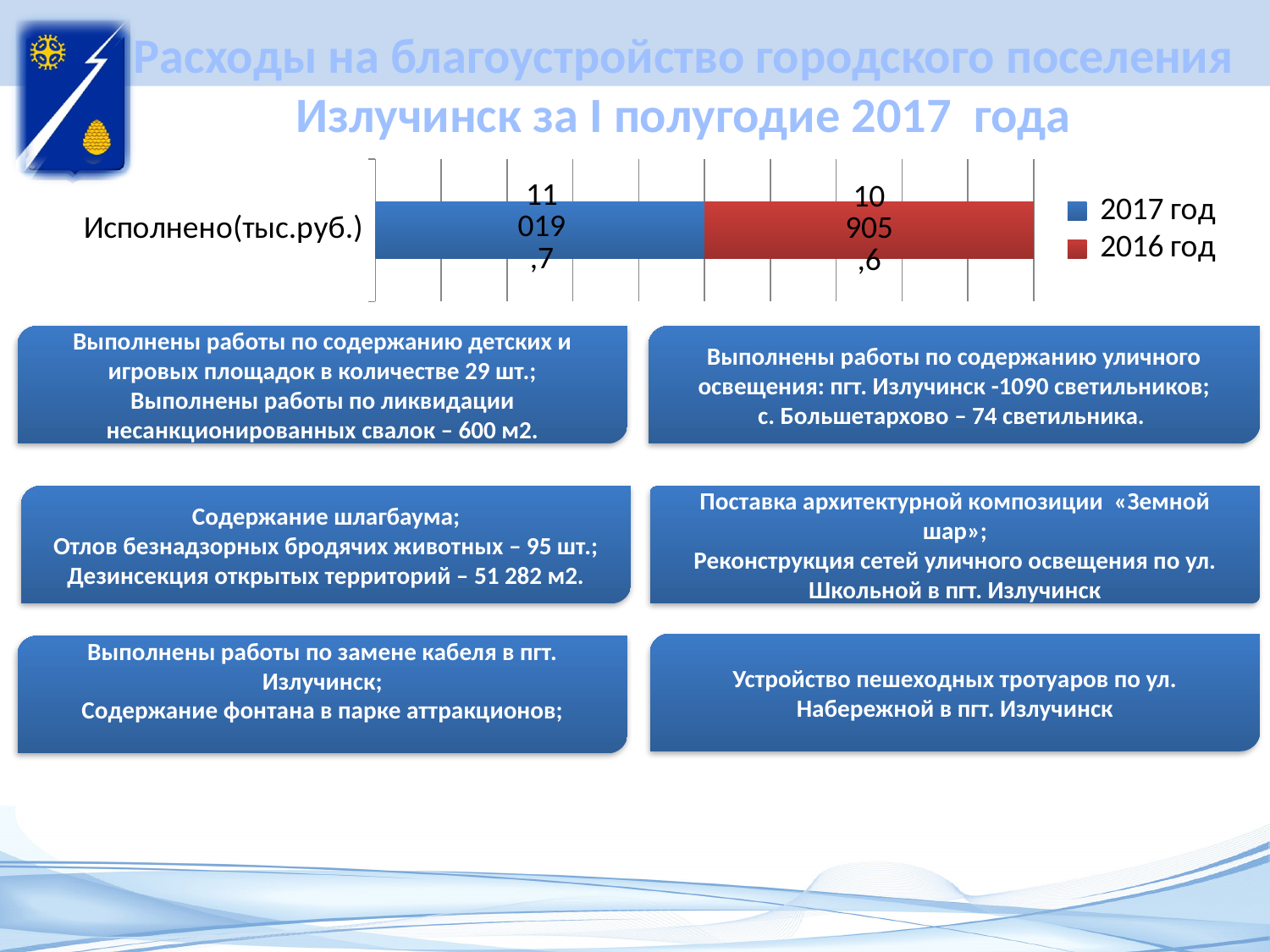
Which series has the largest value in the chart? 2017 год What is the difference between the 2017 год value and the 2016 год value? 114,1 Which colour represents the 2016 год series in the chart? red What is the category label shown on the chart's axis? Исполнено(тыс.руб.) What is the total of the stacked bar for Исполнено(тыс.руб.)? 21 925,3 How many categories are plotted on the chart's axis? 1 How many series does the legend list? 2 What kind of chart is shown on the slide? bar chart Which series has the larger value, 2017 год or 2016 год? 2017 год What is the value for 2016 год in the chart? 10 905,6 What is the value for 2017 год in the chart? 11 019,7 Which series has the smallest value in the chart? 2016 год